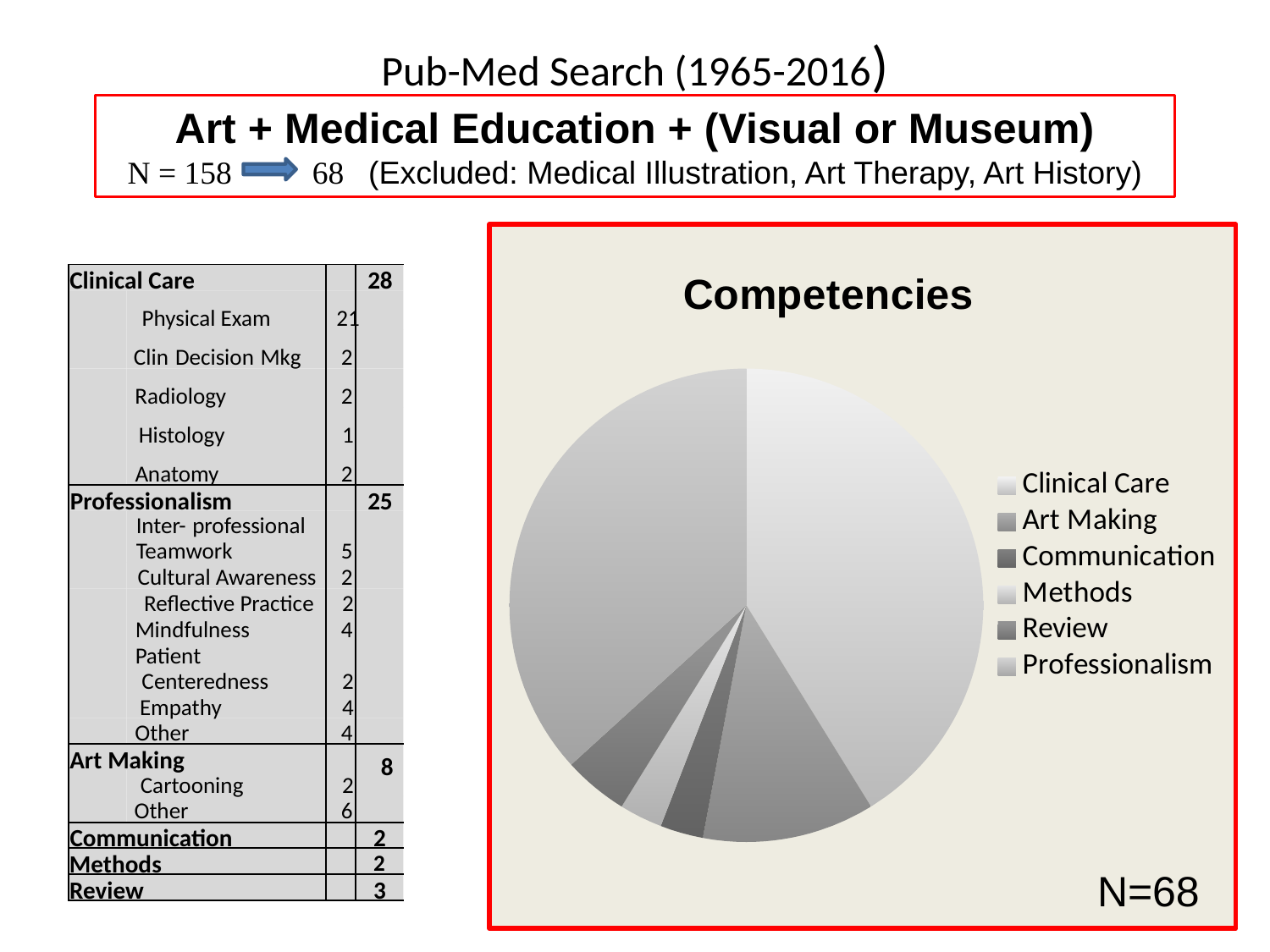
According to the table on the slide, what is the count for Art Making? 8 What is the title of the pie chart? Competencies According to the table on the slide, what is the count for Professionalism? 25 What kind of chart is shown on the slide? pie chart In the pie chart, which slice is larger: Professionalism or Communication? Professionalism According to the table on the slide, what is the difference between the Clinical Care count and the Professionalism count? 3 According to the table on the slide, what is the count for Clinical Care? 28 How many categories does the legend of the pie chart list? 6 In the pie chart, which slice is larger: Art Making or Review? Art Making What total N is shown next to the pie chart? N=68 How many slices does the pie chart have? 6 In the pie chart, which slice is larger: Clinical Care or Art Making? Clinical Care